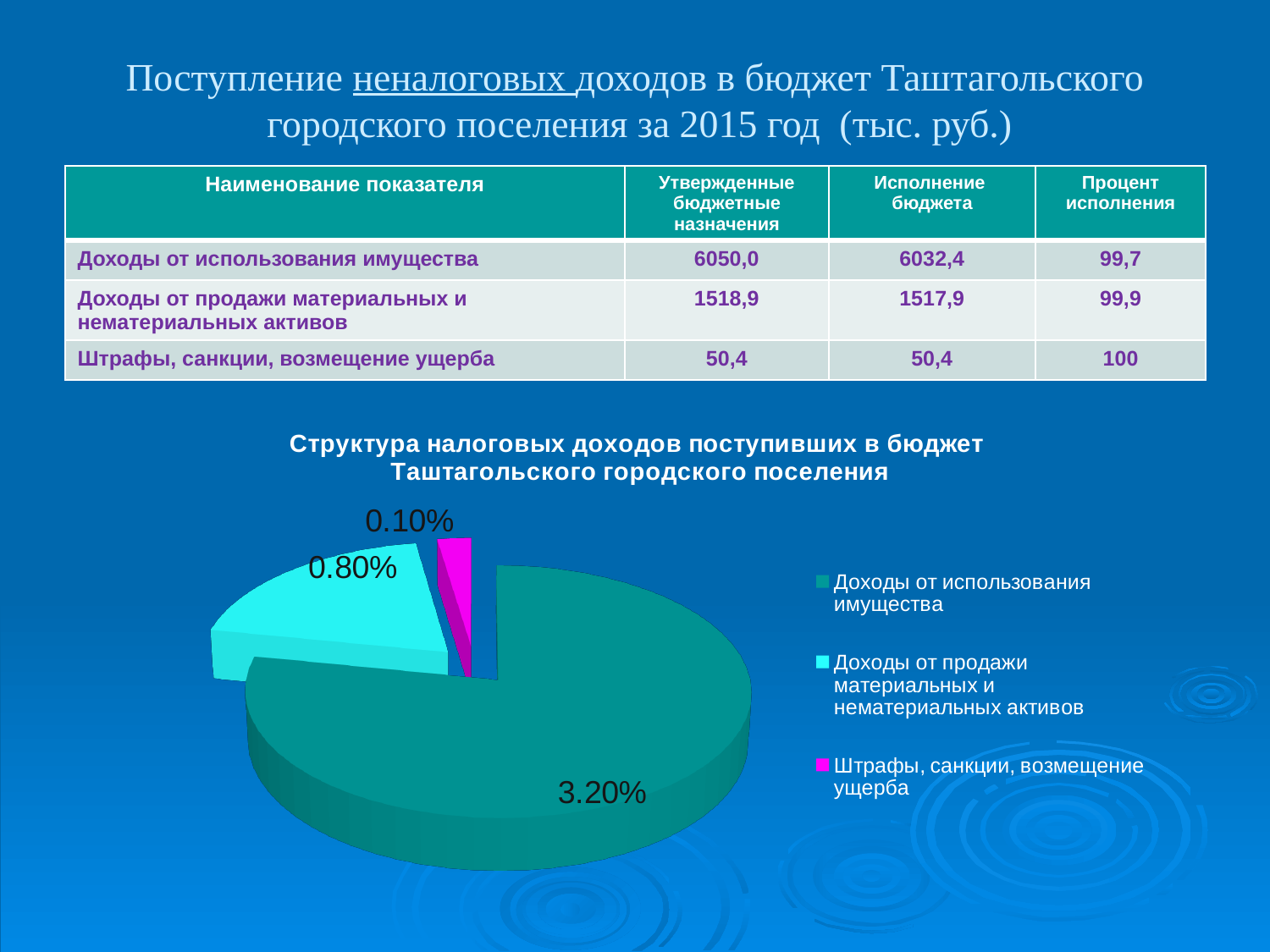
What is the data label for the slice "Штрафы, санкции, возмещение ущерба"? 0.10% What kind of chart is shown on the slide? pie chart What is the data label for the slice "Доходы от продажи материальных и нематериальных активов"? 0.80% Which category has the smallest slice of the pie? Штрафы, санкции, возмещение ущерба What is the data label for the slice "Доходы от использования имущества"? 3.20% How many slices does the pie chart have? 3 What is the difference between the data labels for "Доходы от продажи материальных и нематериальных активов" and "Штрафы, санкции, возмещение ущерба"? 0.70% What is the difference between the data labels for "Доходы от использования имущества" and "Доходы от продажи материальных и нематериальных активов"? 2.40% Which category has the largest slice of the pie? Доходы от использования имущества What colour is the slice for "Штрафы, санкции, возмещение ущерба"? magenta How many entries does the legend list? 3 Which slice is larger: "Доходы от продажи материальных и нематериальных активов" or "Штрафы, санкции, возмещение ущерба"? Доходы от продажи материальных и нематериальных активов